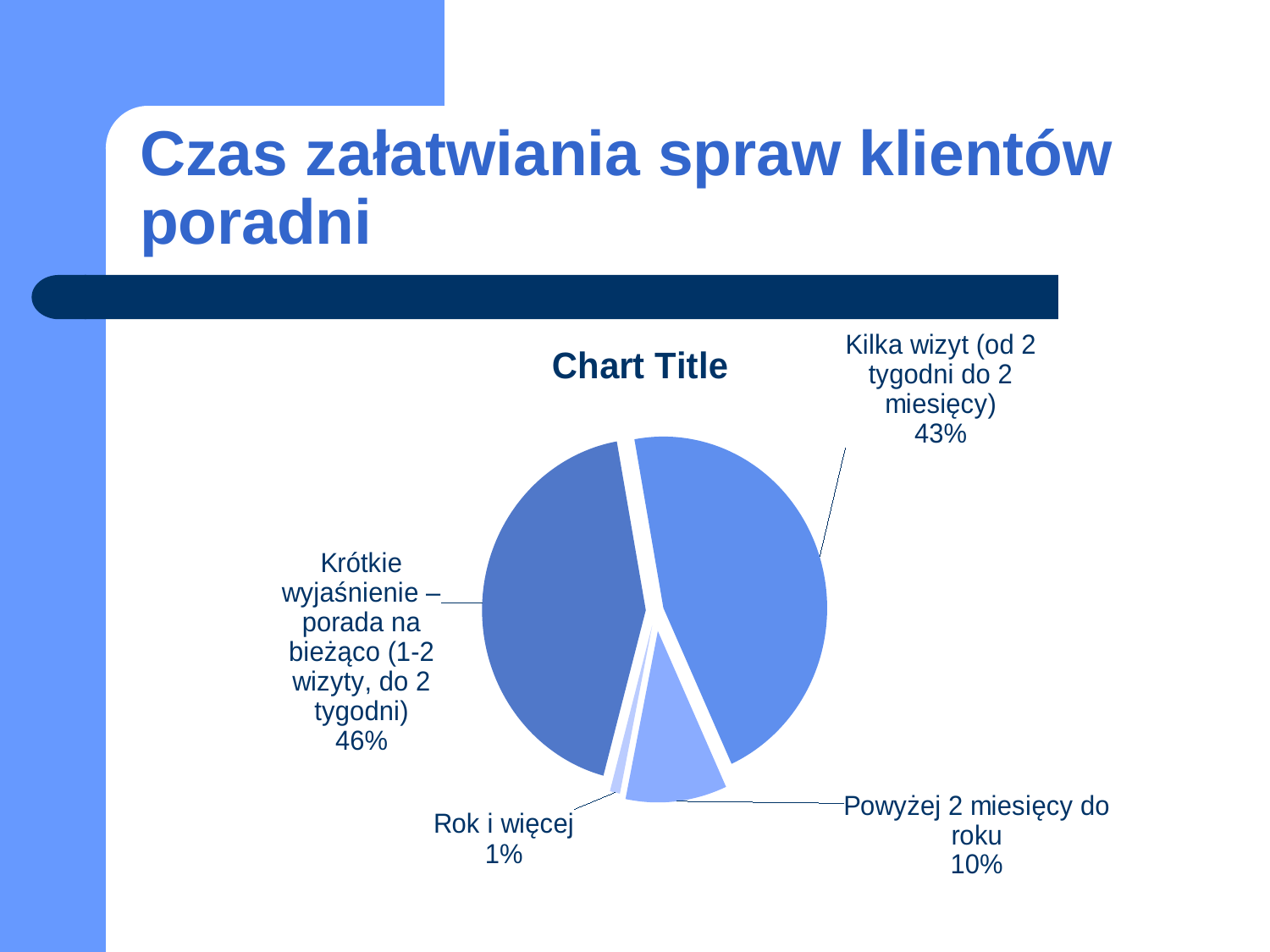
What share of the pie does "Krótkie wyjaśnienie – porada na bieżąco (1-2 wizyty, do 2 tygodni)" represent? 46% Which is larger: the slice for "Powyżej 2 miesięcy do roku" or the slice for "Rok i więcej"? Powyżej 2 miesięcy do roku Which category has the largest slice of the pie? Krótkie wyjaśnienie – porada na bieżąco (1-2 wizyty, do 2 tygodni) What share of the pie does "Rok i więcej" represent? 1% Which category has the smallest slice of the pie? Rok i więcej What share of the pie does "Powyżej 2 miesięcy do roku" represent? 10% What is the difference in percentage points between "Powyżej 2 miesięcy do roku" and "Rok i więcej"? 9 percentage points How many slices does the pie chart have? 4 What is the difference in percentage points between "Krótkie wyjaśnienie – porada na bieżąco (1-2 wizyty, do 2 tygodni)" and "Kilka wizyt (od 2 tygodni do 2 miesięcy)"? 3 percentage points What kind of chart is shown on the slide? pie chart What is the title shown above the pie chart? Chart Title What share of the pie does "Kilka wizyt (od 2 tygodni do 2 miesięcy)" represent? 43%